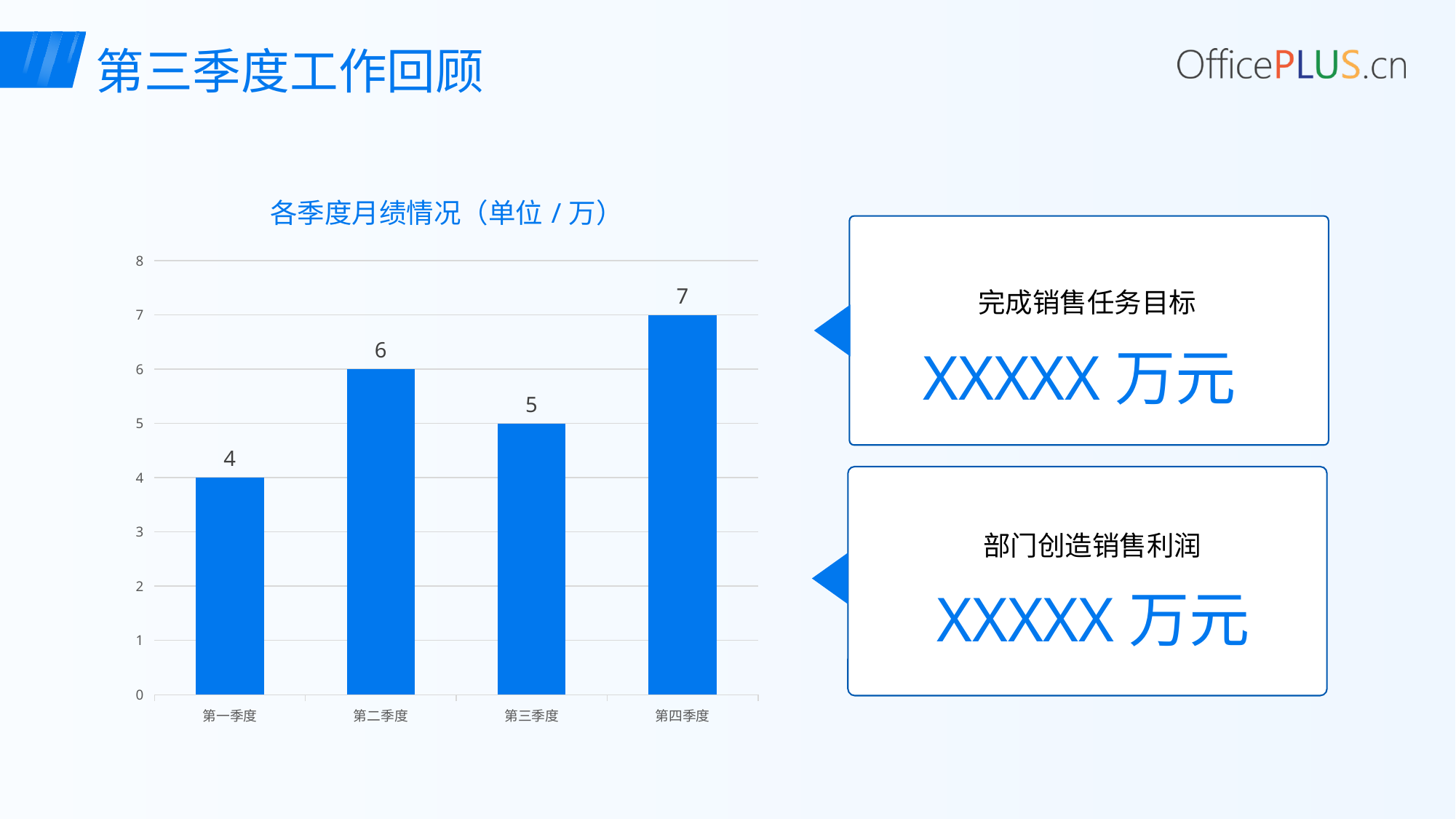
What is the value for 第三季度? 5 What is the difference between the values for 第四季度 and 第一季度? 3 Which quarter has the lowest value? 第一季度 What is the value for 第四季度? 7 What kind of chart is shown on the slide? bar chart Which is larger, the value for 第二季度 or 第三季度? 第二季度 Is the value for 第四季度 greater or less than 6? greater What is the title of the chart? 各季度月绩情况（单位 / 万） Which quarter has the highest value? 第四季度 What is the value for 第一季度? 4 How many categories are shown on the x axis? 4 What is the value for 第二季度? 6